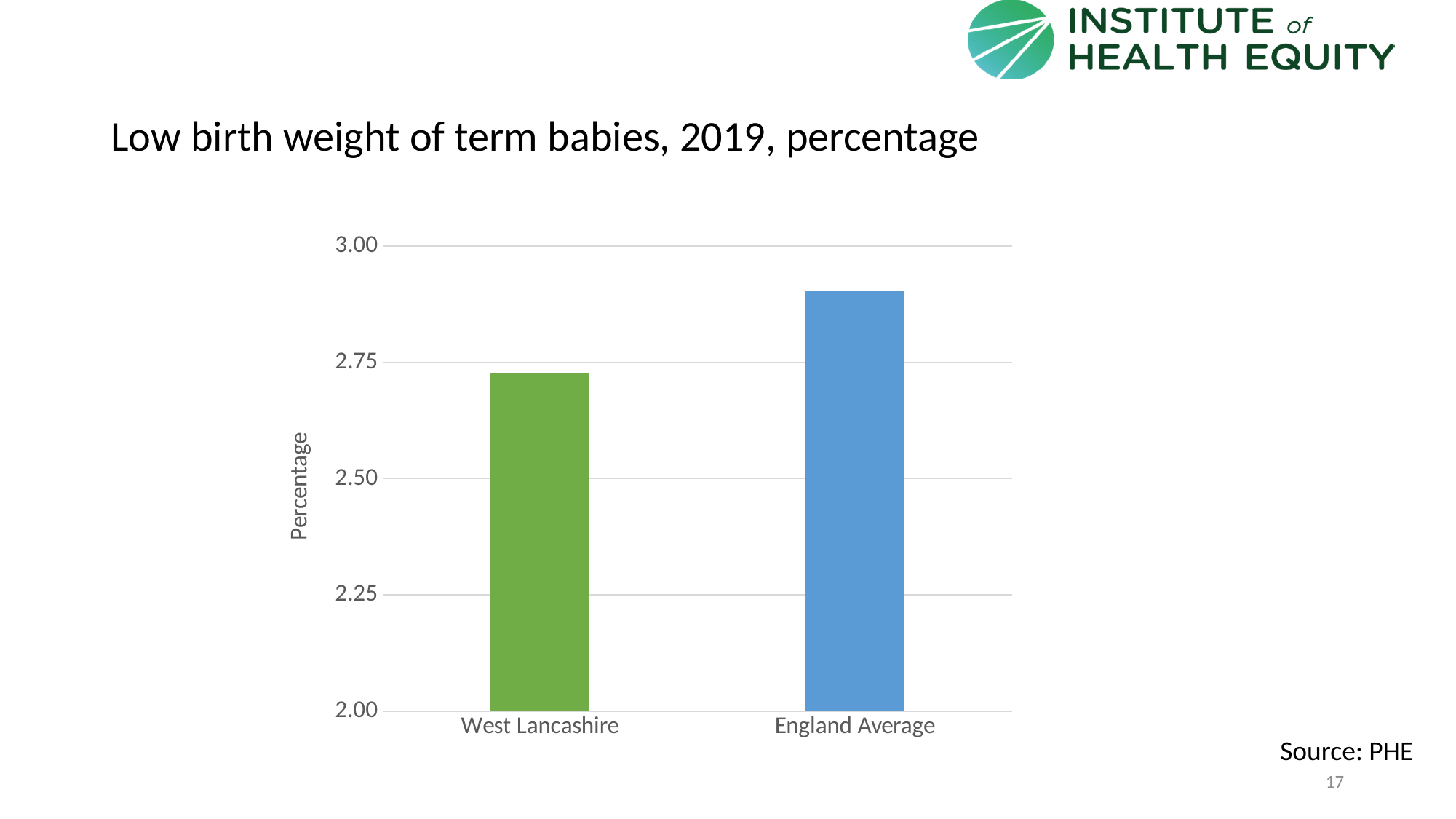
Which category has the lowest value? West Lancashire What is the title of the chart? Low birth weight of term babies, 2019, percentage Is the value for West Lancashire greater or less than 2.50? greater Is the value for West Lancashire greater or less than 2.75? less Is the value for England Average greater or less than 2.75? greater Which is larger, the value for West Lancashire or the value for England Average? England Average How many categories are plotted in the chart? 2 Which category has the highest value? England Average What kind of chart is shown on the slide? bar chart What is the label on the vertical axis? Percentage